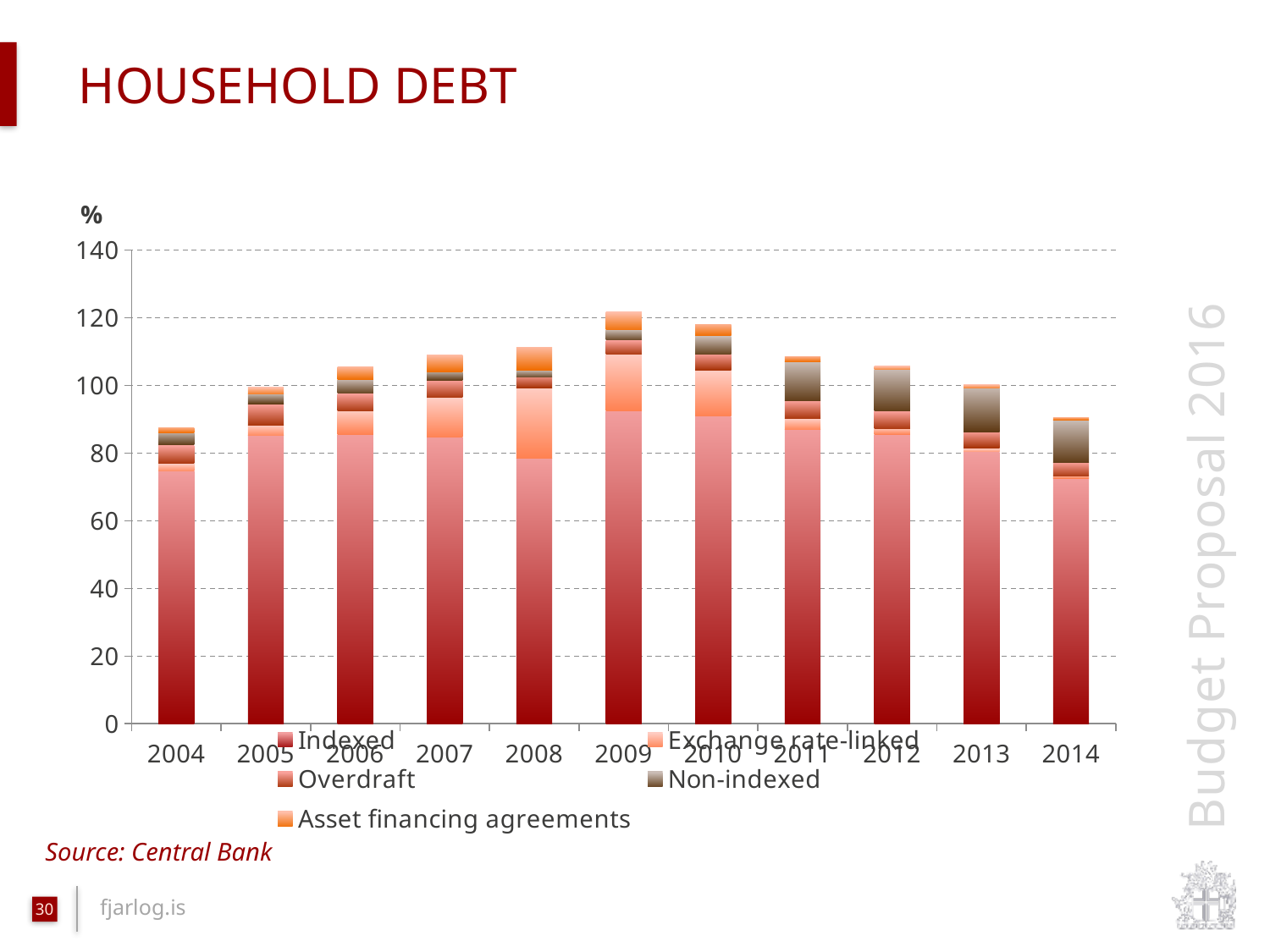
How many years are shown on the x axis of the chart? 11 Which year has the highest total household debt in the chart? 2009 Which year has the larger total household debt, 2009 or 2004? 2009 Is the total household debt for 2014 greater or less than 100? less Is the total household debt for 2004 greater or less than 100? less Which series is listed first in the chart's legend? Indexed Do the total household debt values rise or fall from 2009 to 2014? fall What unit is shown at the top of the y axis of the chart? % Is the total household debt for 2008 greater or less than 100? greater What kind of chart is shown on the slide? Stacked bar chart How many series does the chart's legend list? 5